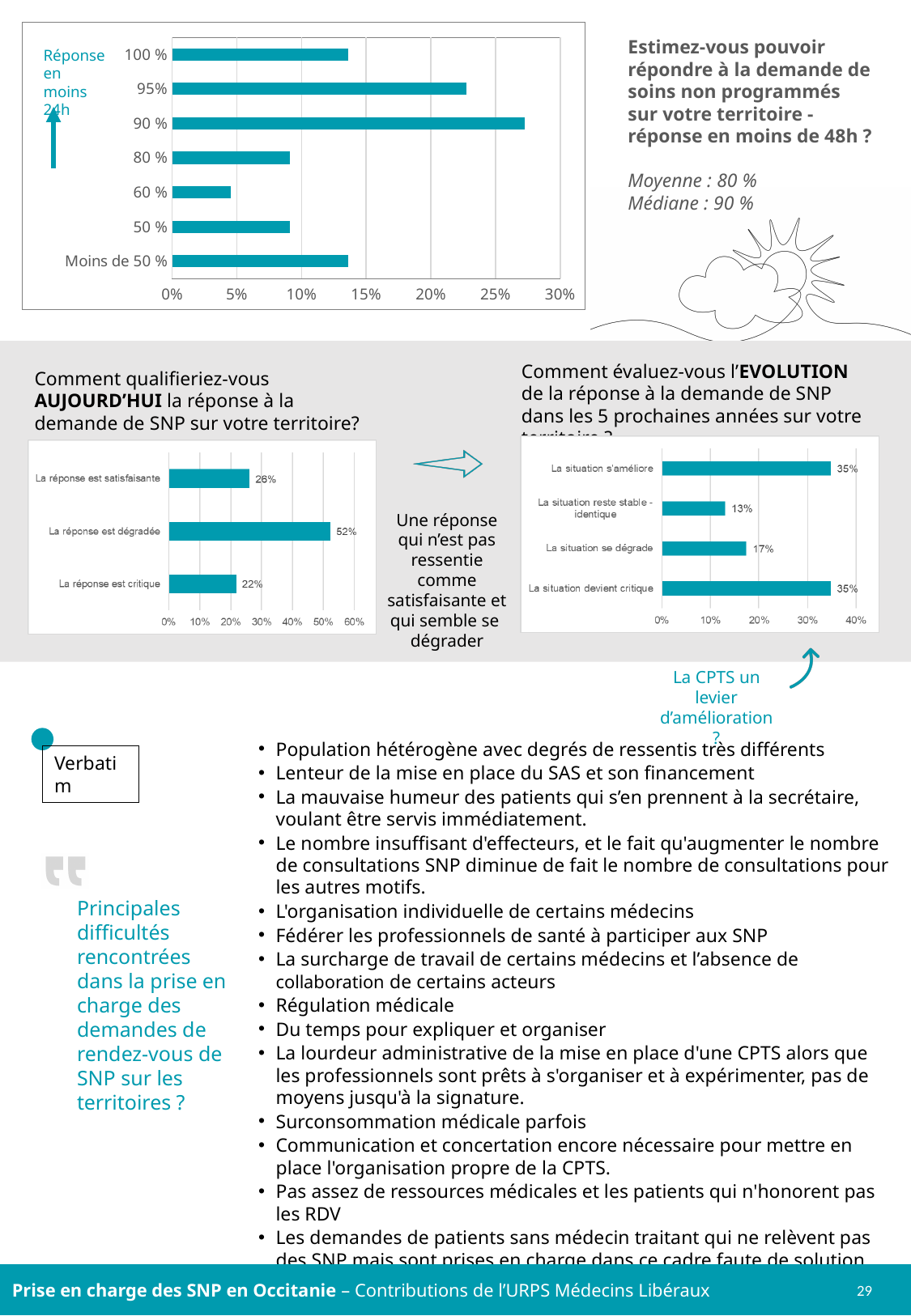
In the chart 'Comment évaluez-vous l'EVOLUTION de la réponse à la demande de SNP', how many categories are plotted? 4 In the chart 'Comment évaluez-vous l'EVOLUTION de la réponse à la demande de SNP', what percentage is shown for 'La situation reste stable - identique'? 13% In the chart 'Comment évaluez-vous l'EVOLUTION de la réponse à la demande de SNP', which category has the lowest value? La situation reste stable - identique In the chart 'Comment évaluez-vous l'EVOLUTION de la réponse à la demande de SNP', which is larger: 'La situation se dégrade' or 'La situation reste stable - identique'? La situation se dégrade In the chart 'Comment évaluez-vous l'EVOLUTION de la réponse à la demande de SNP', what percentage is shown for 'La situation se dégrade'? 17% In the chart 'Comment qualifieriez-vous AUJOURD'HUI la réponse à la demande de SNP sur votre territoire?', which category has the highest value? La réponse est dégradée In the top chart 'Estimez-vous pouvoir répondre à la demande de soins non programmés... réponse en moins de 48h ?', which category has the longest bar? 90 % What type of chart is the top chart 'Estimez-vous pouvoir répondre à la demande de soins non programmés... réponse en moins de 48h ?'? Bar chart In the chart 'Comment qualifieriez-vous AUJOURD'HUI la réponse à la demande de SNP sur votre territoire?', what percentage is shown for 'La réponse est dégradée'? 52% In the top chart 'Estimez-vous pouvoir répondre à la demande de soins non programmés... réponse en moins de 48h ?', is the value for '60 %' greater or less than 5%? less In the chart 'Comment qualifieriez-vous AUJOURD'HUI la réponse à la demande de SNP sur votre territoire?', what percentage is shown for 'La réponse est critique'? 22% In the chart 'Comment qualifieriez-vous AUJOURD'HUI la réponse à la demande de SNP sur votre territoire?', what is the difference between 'La réponse est dégradée' and 'La réponse est satisfaisante'? 26%